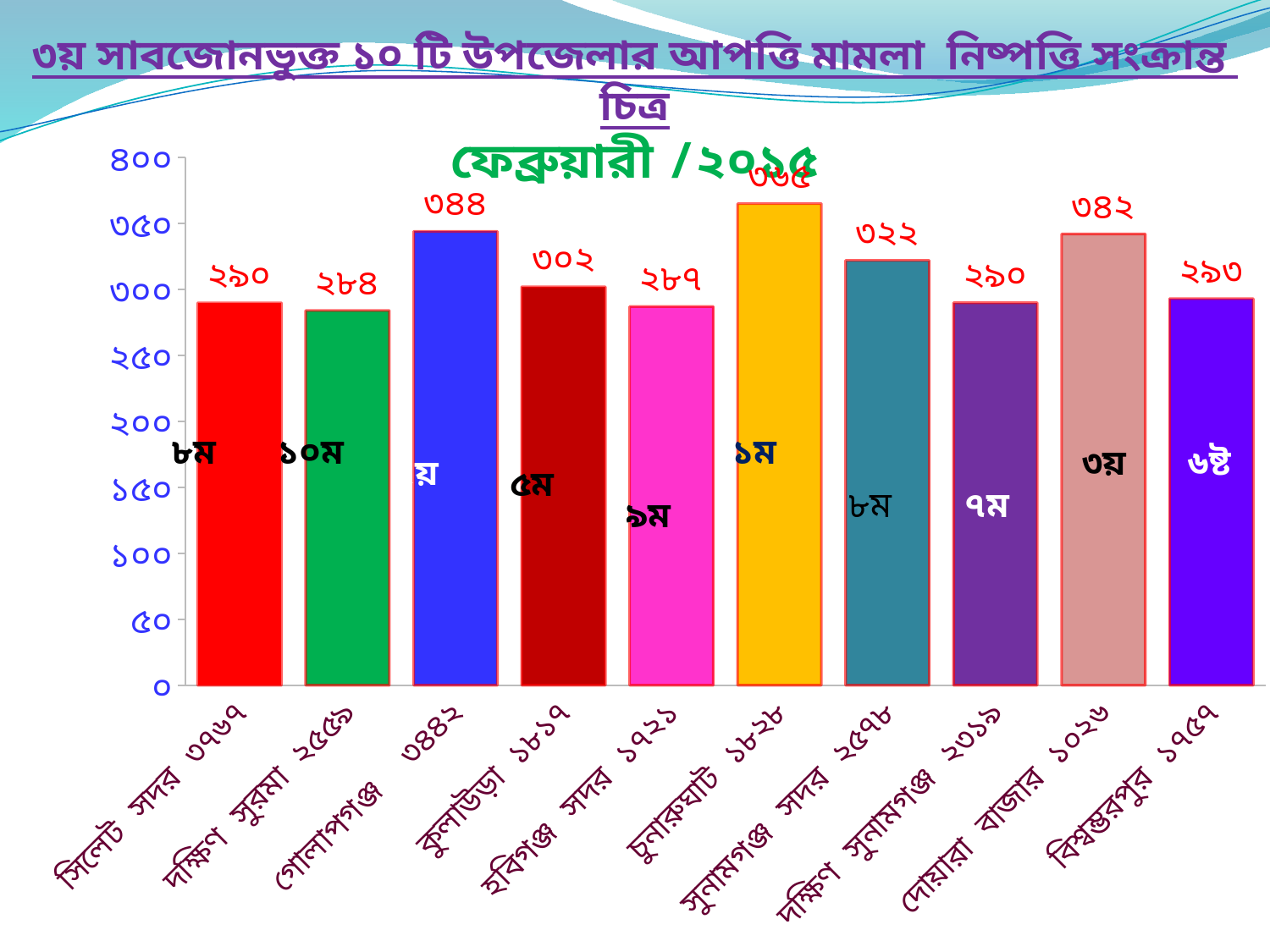
What is the value shown for চুনারুঘাট ১৮২৮? ৩৬৫ What is the value shown for গোলাপগঞ্জ ৩৪৪২? ৩৪৪ What is the value shown for সুনামগঞ্জ সদর ২৫৭৮? ৩২২ What is the difference between the values for চুনারুঘাট ১৮২৮ and দক্ষিণ সুরমা ২৫৫৯? ৮১ Which category has the lowest value? দক্ষিণ সুরমা ২৫৫৯ Which category has the highest value? চুনারুঘাট ১৮২৮ What is the value shown for দক্ষিণ সুরমা ২৫৫৯? ২৮৪ Is the value for চুনারুঘাট ১৮২৮ greater or less than ৩৫০? greater Which month and year does the chart subtitle refer to? ফেব্রুয়ারী /২০১৫ What kind of chart is shown on the slide? bar chart How many categories (bars) are shown in the chart? 10 Which has the larger value, কুলাউড়া ১৮১৭ or হবিগঞ্জ সদর ১৭২১? কুলাউড়া ১৮১৭